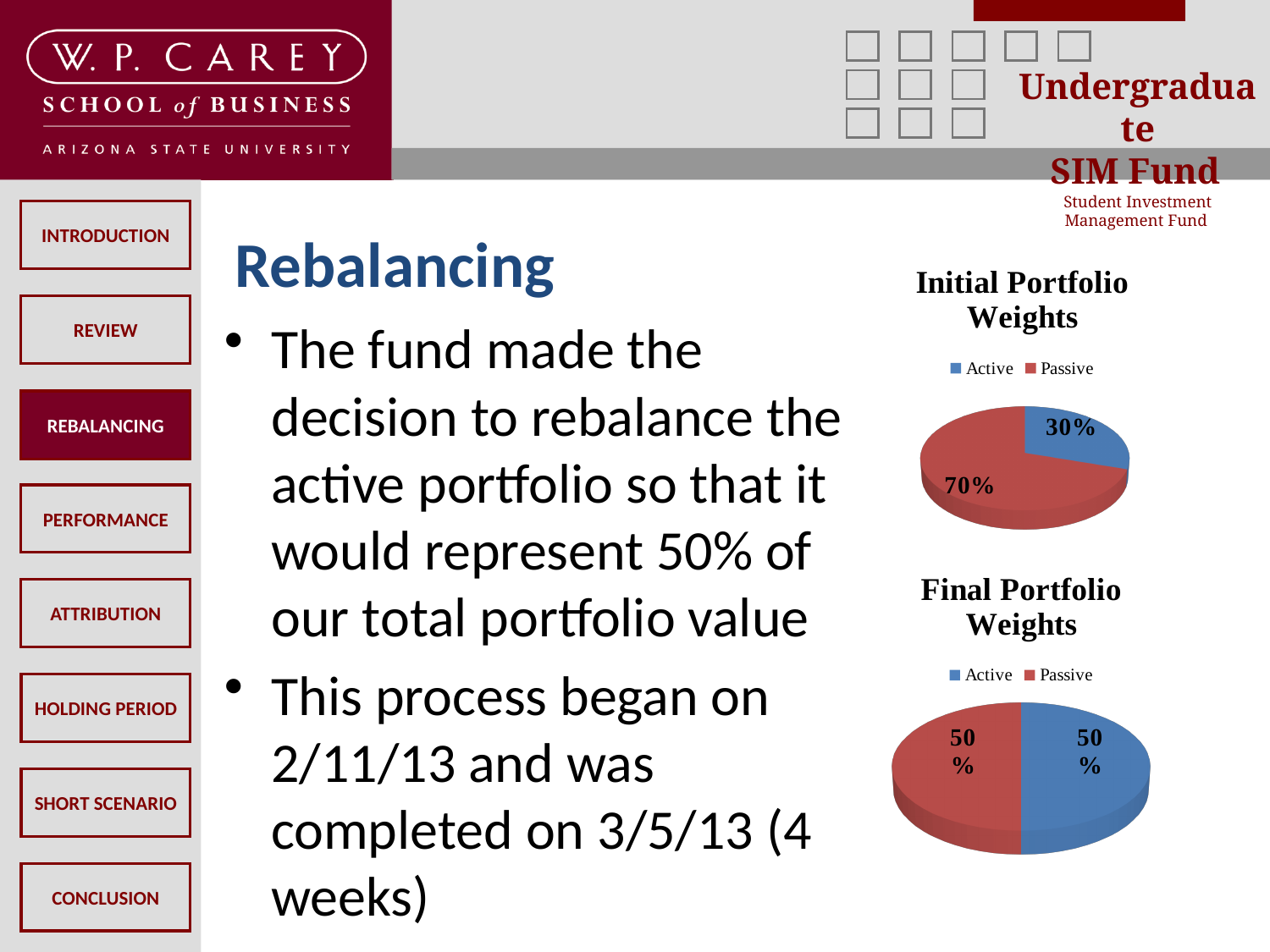
In the Final Portfolio Weights chart, what share does Active have? 50% In the Initial Portfolio Weights chart, what share does Passive have? 70% In the Initial Portfolio Weights chart, which slice is the smallest? Active In the Initial Portfolio Weights chart, what is the difference between the Passive and Active shares? 40% In the Initial Portfolio Weights chart, which slice is the largest? Passive How many entries does the legend of the Final Portfolio Weights chart list? 2 In the Initial Portfolio Weights chart, which is larger, Active or Passive? Passive In the Final Portfolio Weights chart, what share does Passive have? 50% What kind of chart is the Final Portfolio Weights chart? Pie chart How many slices does the Initial Portfolio Weights chart have? 2 In the Final Portfolio Weights chart, what colour is the Active slice? Blue